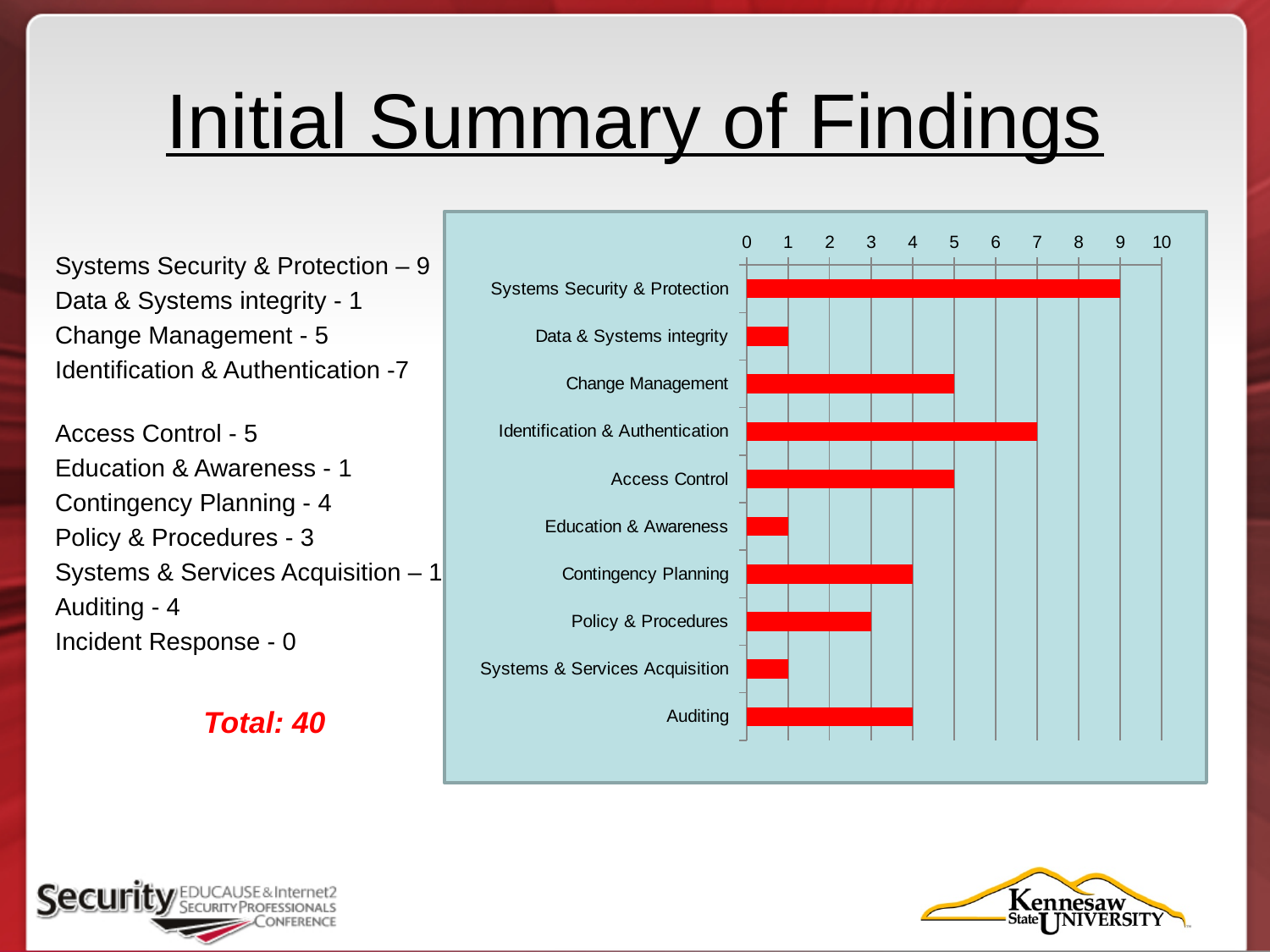
What colour are the bars in the chart? red What kind of chart is shown on the slide? bar chart Is the value for Education & Awareness greater or less than 3? less Which is larger, the value for Change Management or the value for Contingency Planning? Change Management What is the difference between the values for Systems Security & Protection and Identification & Authentication? 2 Is the value for Identification & Authentication greater or less than 5? greater How many categories are plotted in the chart? 10 What is the value for Identification & Authentication? 7 What is the value for Systems Security & Protection? 9 Which category has the highest value in the chart? Systems Security & Protection What is the difference between the values for Access Control and Auditing? 1 What is the value for Policy & Procedures? 3